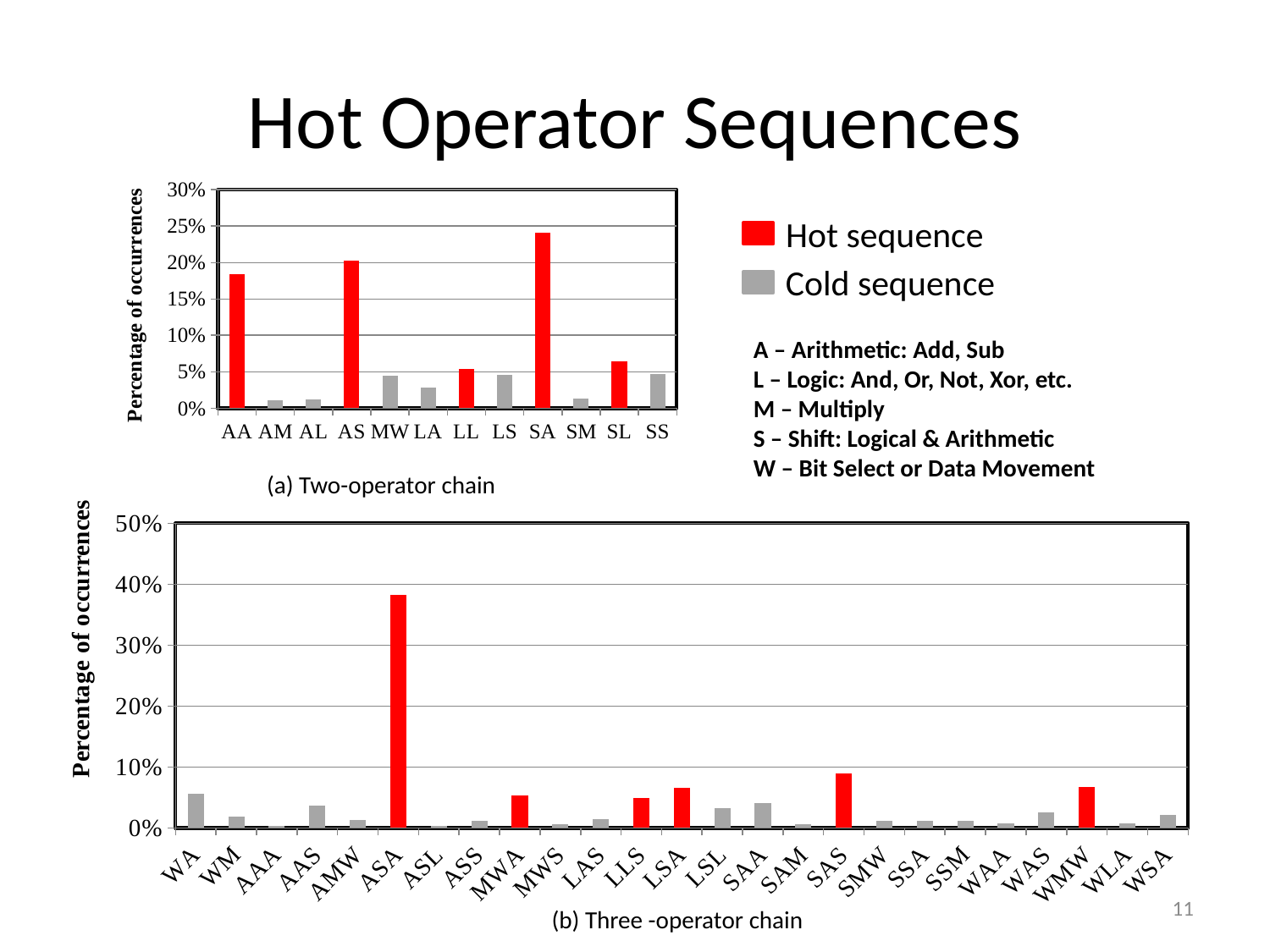
In the (b) Three-operator chain chart, which operator sequence has the highest percentage of occurrences? ASA What colour are the bars for the Hot sequence series? red How many operator sequences are shown on the x axis of the (a) Two-operator chain chart? 12 In the (a) Two-operator chain chart, is the value for LL greater or less than 10%? less In the (a) Two-operator chain chart, which has the larger value, SA or AA? SA In the (b) Three-operator chain chart, is the value for LSA greater or less than 10%? less In the (a) Two-operator chain chart, which operator sequence has the highest percentage of occurrences? SA In the (a) Two-operator chain chart, is the value for AA greater or less than 15%? greater How many series does the legend list? 2 What kind of chart is the (a) Two-operator chain chart? bar chart How many operator sequences are shown on the x axis of the (b) Three-operator chain chart? 25